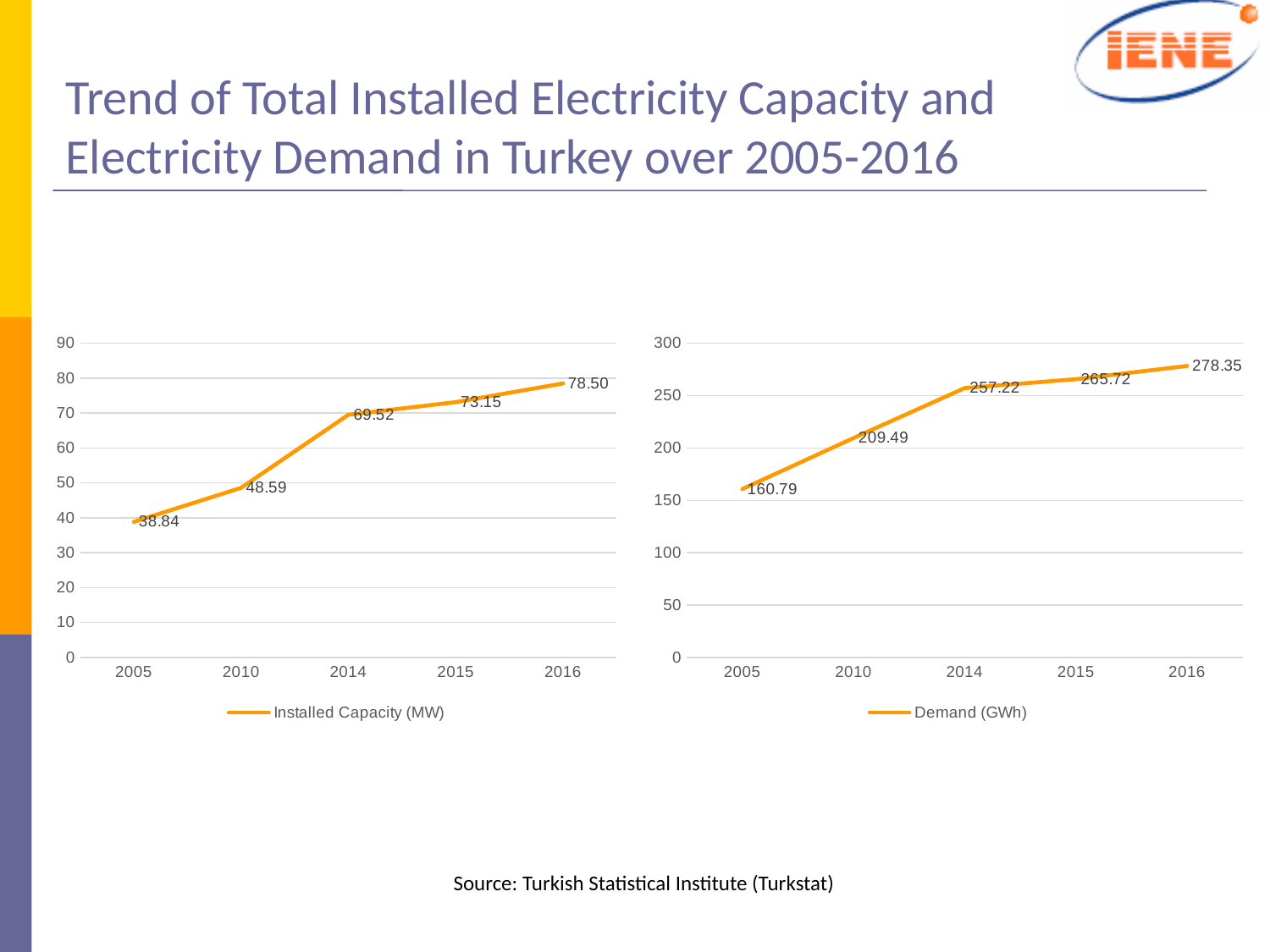
In the left chart (Installed Capacity), is the value for 2010 greater or less than 50? less What kind of chart is the left chart (Installed Capacity)? line chart In the right chart (Demand), what is the difference between the 2014 and 2010 values? 47.73 In the right chart (Demand), do the values rise or fall from 2005 to 2016? rise In the right chart (Demand), what is the value for 2010? 209.49 What series name does the legend of the left chart show? Installed Capacity (MW) In the left chart (Installed Capacity), what is the value for 2014? 69.52 In the left chart (Installed Capacity), what is the difference between the 2016 and 2005 values? 39.66 In the right chart (Demand), which is larger, the value for 2015 or the value for 2014? 2015 In the left chart (Installed Capacity), which year has the lowest value? 2005 In the right chart (Demand), which year has the highest value? 2016 How many data points are plotted in the right chart (Demand)? 5